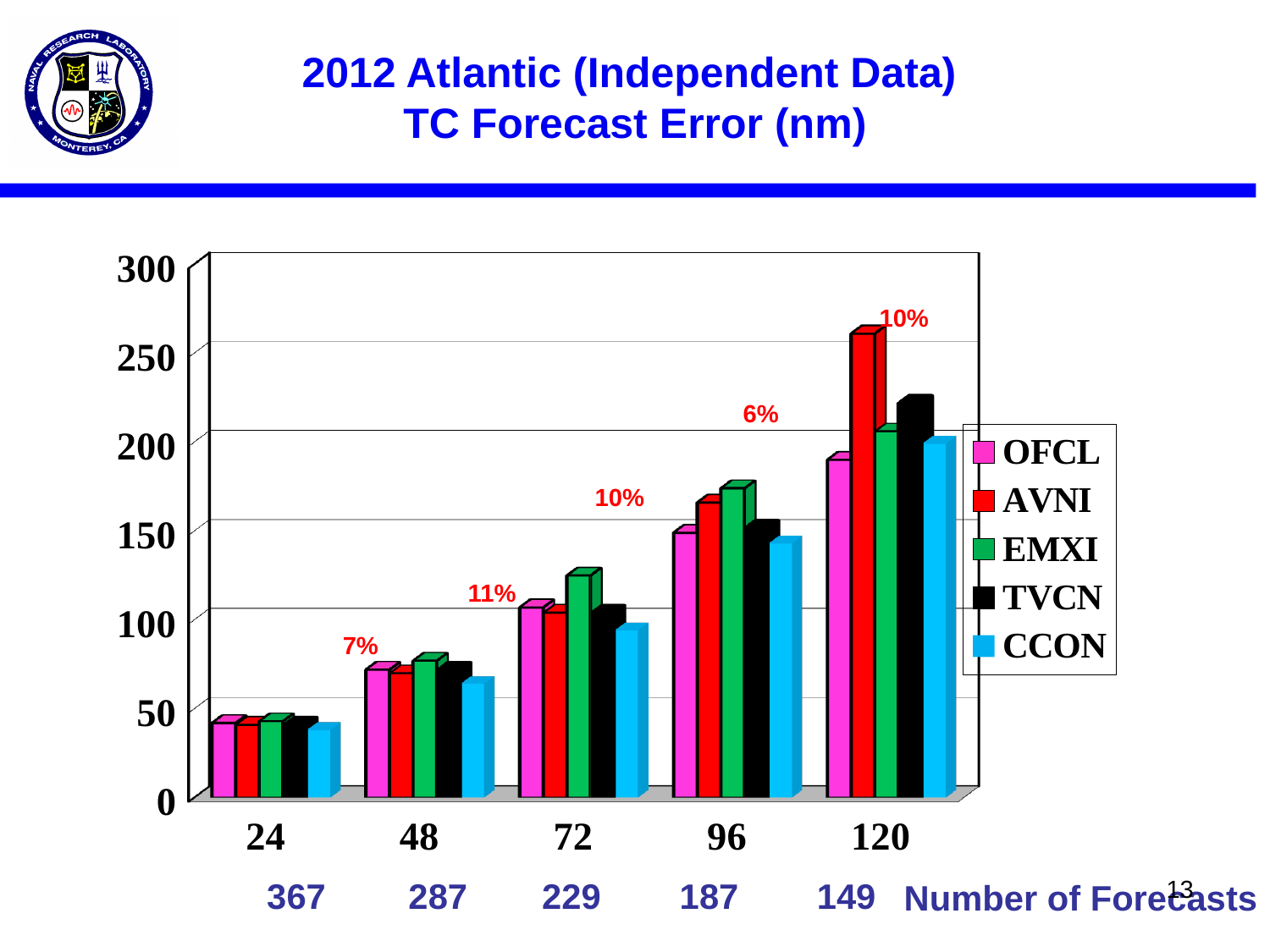
Which series has the highest forecast error at 72 hours? EMXI What is the number of forecasts shown for the 24-hour category? 367 What percentage label is printed above the 96-hour group of bars? 6% Which series has the highest forecast error at 120 hours? AVNI How many forecast-hour categories are shown on the x axis? 5 What kind of chart is shown on the slide? bar chart Which series has the lowest forecast error at 72 hours? CCON Is the value for OFCL at 120 hours greater or less than 200? less Do the forecast errors rise or fall as the forecast hour increases from 24 to 120? rise How many series does the legend list? 5 Is the value for CCON at 24 hours greater or less than 50? less Is the value for AVNI at 120 hours greater or less than 250? greater